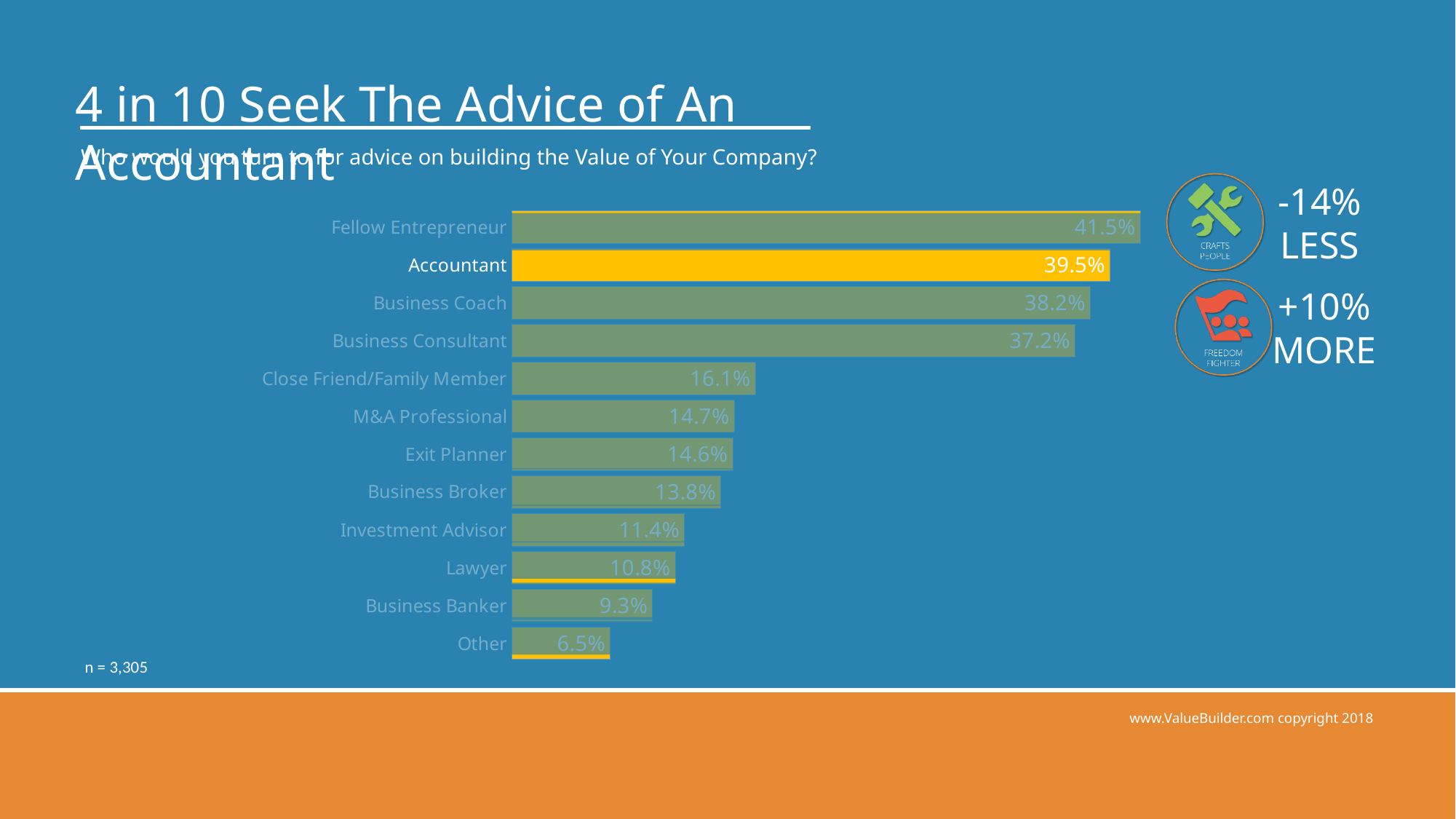
What is the value shown for Close Friend/Family Member? 16.1% How many categories are shown in the bar chart? 12 What percentage of respondents would turn to an Accountant for advice on building the value of their company? 39.5% What type of chart is shown on the slide? Bar chart What is the difference between the values for Fellow Entrepreneur and Accountant? 2.0% Which bar in the chart is highlighted in a different colour (yellow) from the others? Accountant What is the value shown for Business Coach? 38.2% Which category has the lowest value in the chart? Other Which is larger, the value for M&A Professional or the value for Business Broker? M&A Professional What is the value shown for Business Banker? 9.3% What is the difference between the values for Business Consultant and Lawyer? 26.4% Which category has the highest value in the chart? Fellow Entrepreneur